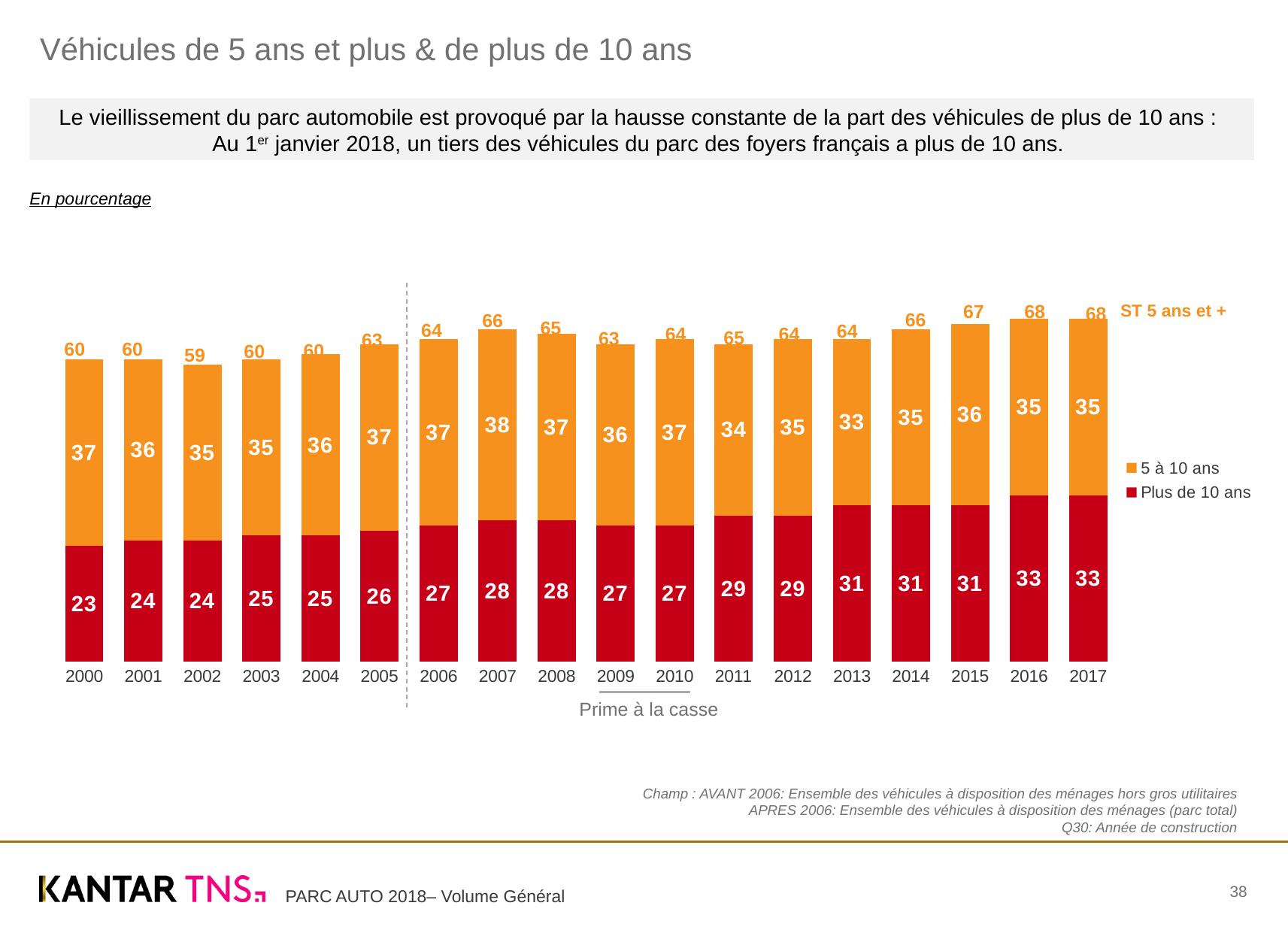
What is the value for 'Plus de 10 ans' in 2000? 23 What is the difference between the 'Plus de 10 ans' value in 2017 and in 2000? 10 How many series does the legend list? 2 What is the value for 'Plus de 10 ans' in 2017? 33 What is the 'ST 5 ans et +' total printed above the bar for 2015? 67 Which year has the lowest 'ST 5 ans et +' total? 2002 Is the 'Plus de 10 ans' value larger in 2013 or in 2010? 2013 What is the value for '5 à 10 ans' in 2007? 38 How many years are shown on the x axis of the chart? 18 What type of chart is shown on the slide? stacked bar chart Which year has the highest value for '5 à 10 ans'? 2007 Does the 'Plus de 10 ans' series generally rise or fall from 2000 to 2017? rise